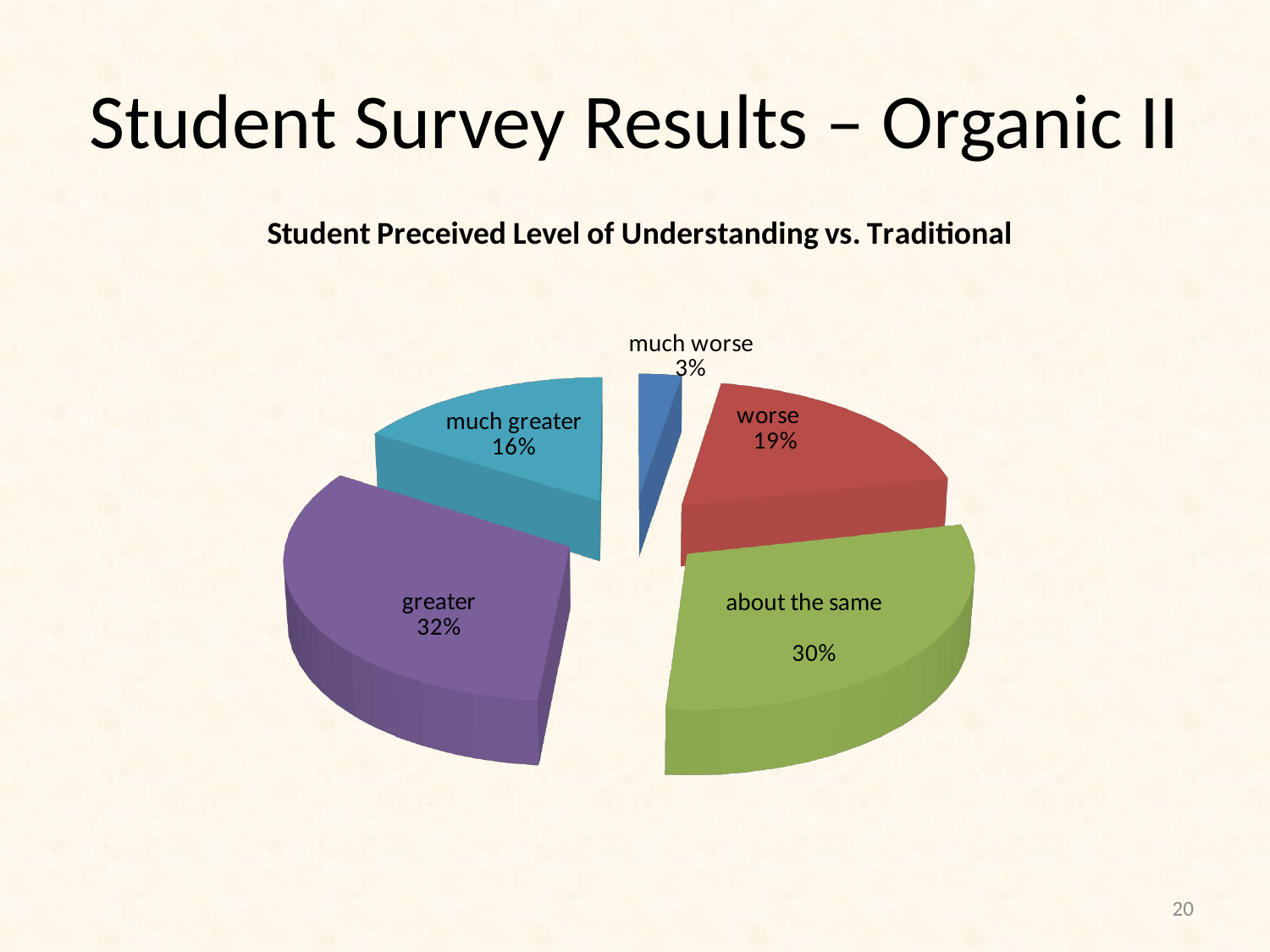
What type of chart is shown on the slide? pie chart Which is larger, the share for 'worse' or the share for 'much greater'? worse What is the title of the chart? Student Preceived Level of Understanding vs. Traditional What percentage of students reported 'much greater' understanding? 16% What percentage of students reported 'much worse' understanding? 3% How many categories are shown in the pie chart? 5 Which category has the smallest share of the pie? much worse What percentage of students reported 'about the same' understanding? 30% What colour is the 'about the same' slice? green What is the difference between the 'worse' and 'much worse' percentages? 16% Which category has the largest share of the pie? greater What percentage of students reported 'greater' understanding? 32%